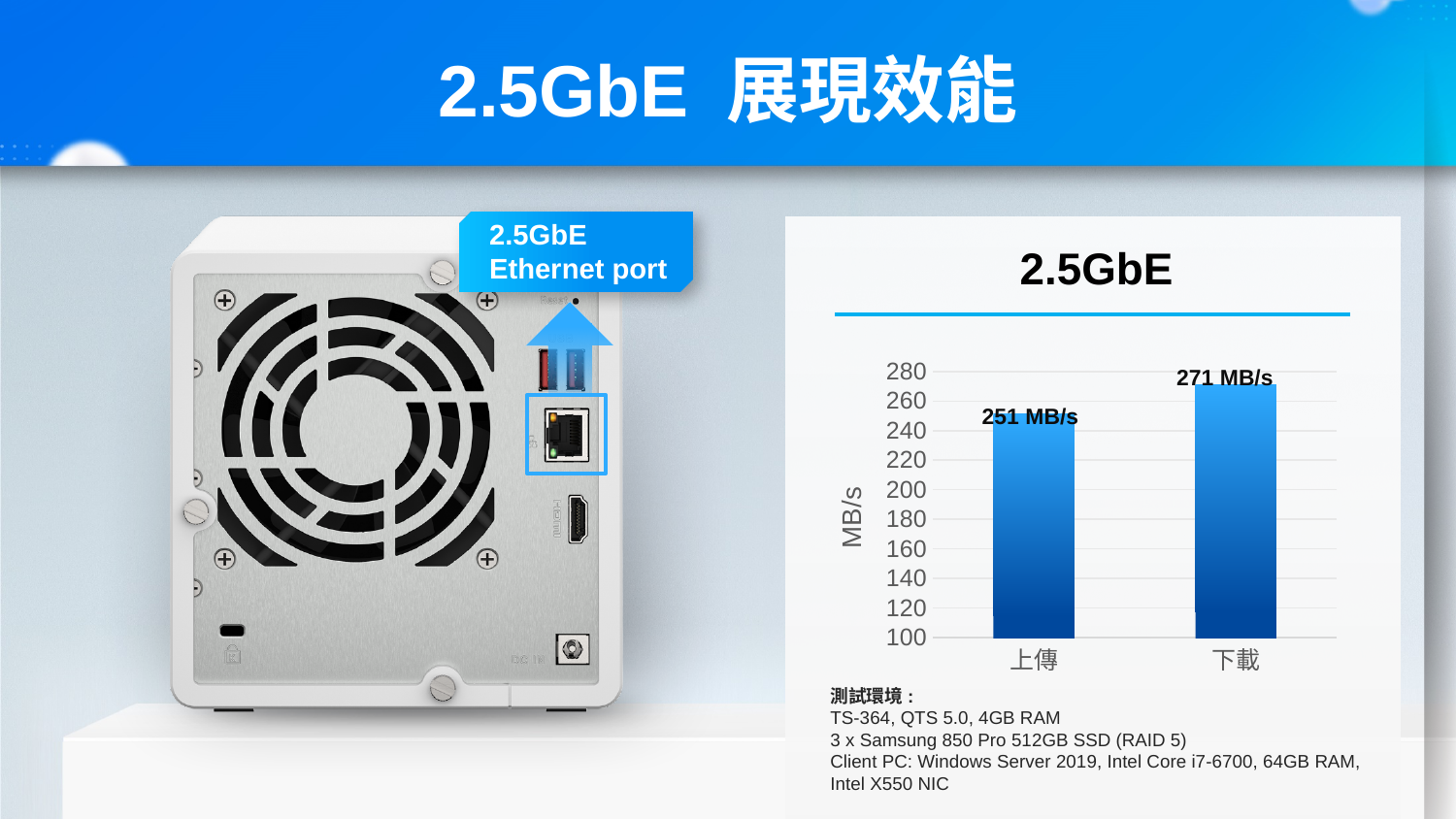
What is the difference between the 下載 and 上傳 values in the 2.5GbE chart? 20 MB/s What is the label on the vertical axis of the 2.5GbE chart? MB/s Which category has the lowest value in the 2.5GbE chart? 上傳 Is the value for 上傳 in the 2.5GbE chart greater or less than 240? greater Which category has the highest value in the 2.5GbE chart? 下載 What is the value for 上傳 (upload) in the 2.5GbE chart? 251 MB/s How many categories are shown in the 2.5GbE chart? 2 What kind of chart is the 2.5GbE chart? bar chart Which is larger in the 2.5GbE chart, the value for 上傳 or for 下載? 下載 Is the value for 下載 in the 2.5GbE chart greater or less than 280? less What is the value for 下載 (download) in the 2.5GbE chart? 271 MB/s What is the title of the chart on the slide? 2.5GbE